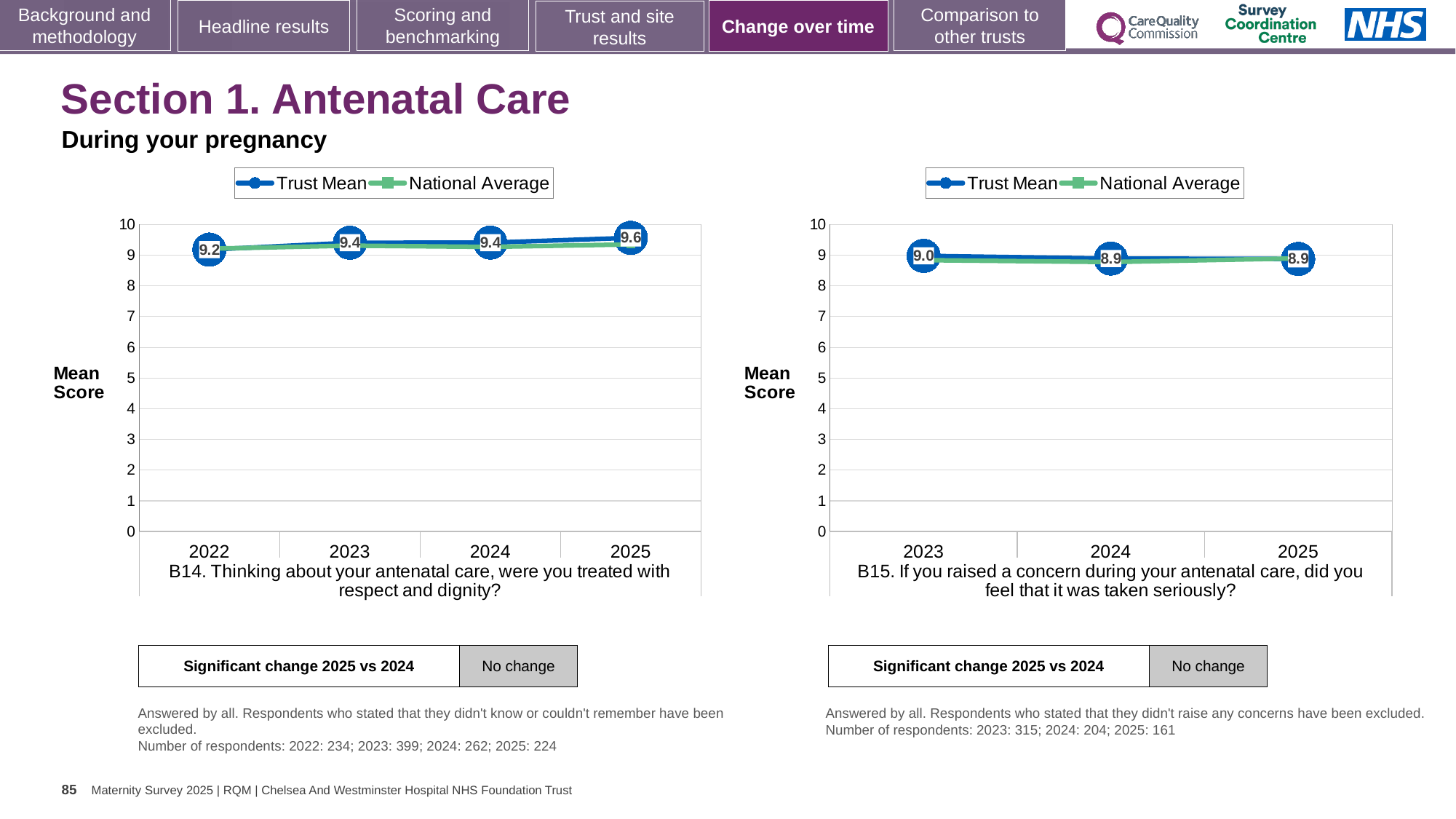
On the B15 chart (right), what is the Trust Mean for 2025? 8.9 On the B14 chart (left), does the Trust Mean rise or fall from 2022 to 2025? Rise How many series does the legend of the B14 chart (left) list? 2 On the B14 chart (left), which year has the highest Trust Mean? 2025 How many years are plotted on the B15 chart (right)? 3 On the B15 chart (right), what is the Trust Mean for 2023? 9.0 On the B14 chart (left), what is the difference between the Trust Mean in 2025 and in 2022? 0.4 On the B15 chart (right), is the Trust Mean for 2023 greater or less than 8? greater What kind of chart is the B14 chart (left)? Line chart On the B14 chart (left), what is the Trust Mean for 2022? 9.2 On the B14 chart (left), what is the Trust Mean for 2025? 9.6 On the B14 chart (left), which year has the lowest Trust Mean? 2022